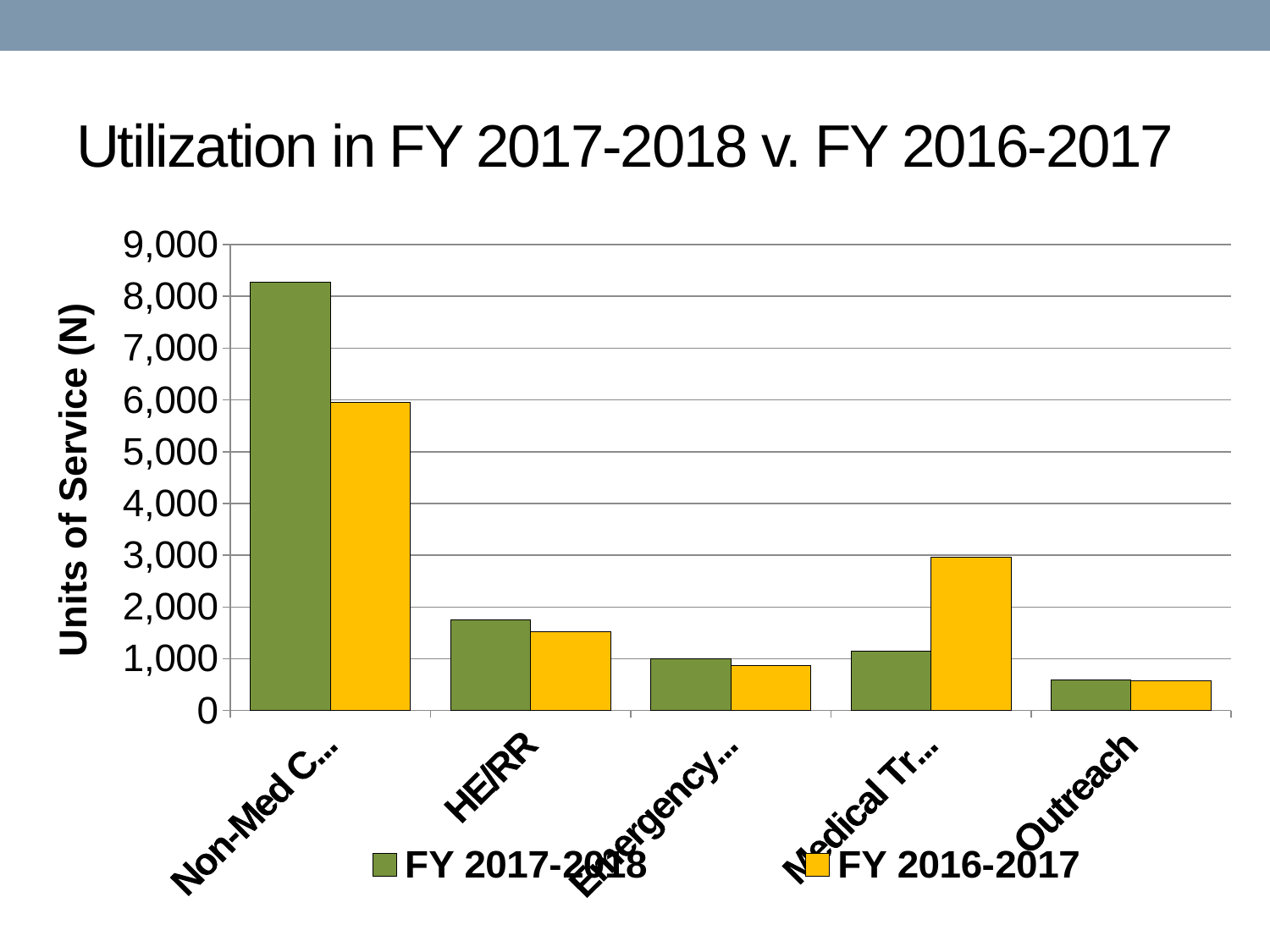
Is the FY 2016-2017 value for HE/RR greater or less than 2,000? less What is the title of the chart? Utilization in FY 2017-2018 v. FY 2016-2017 Which category has the lowest FY 2016-2017 value? Outreach How many categories are shown on the x axis? 5 Is the FY 2017-2018 value for Outreach greater or less than 1,000? less Is the FY 2016-2017 value for Outreach greater or less than 1,000? less What kind of chart is shown on the slide? Bar chart For HE/RR, which series has the larger value, FY 2017-2018 or FY 2016-2017? FY 2017-2018 How many series does the legend list? 2 Which category has the lowest FY 2017-2018 value? Outreach What is the label on the vertical axis? Units of Service (N)